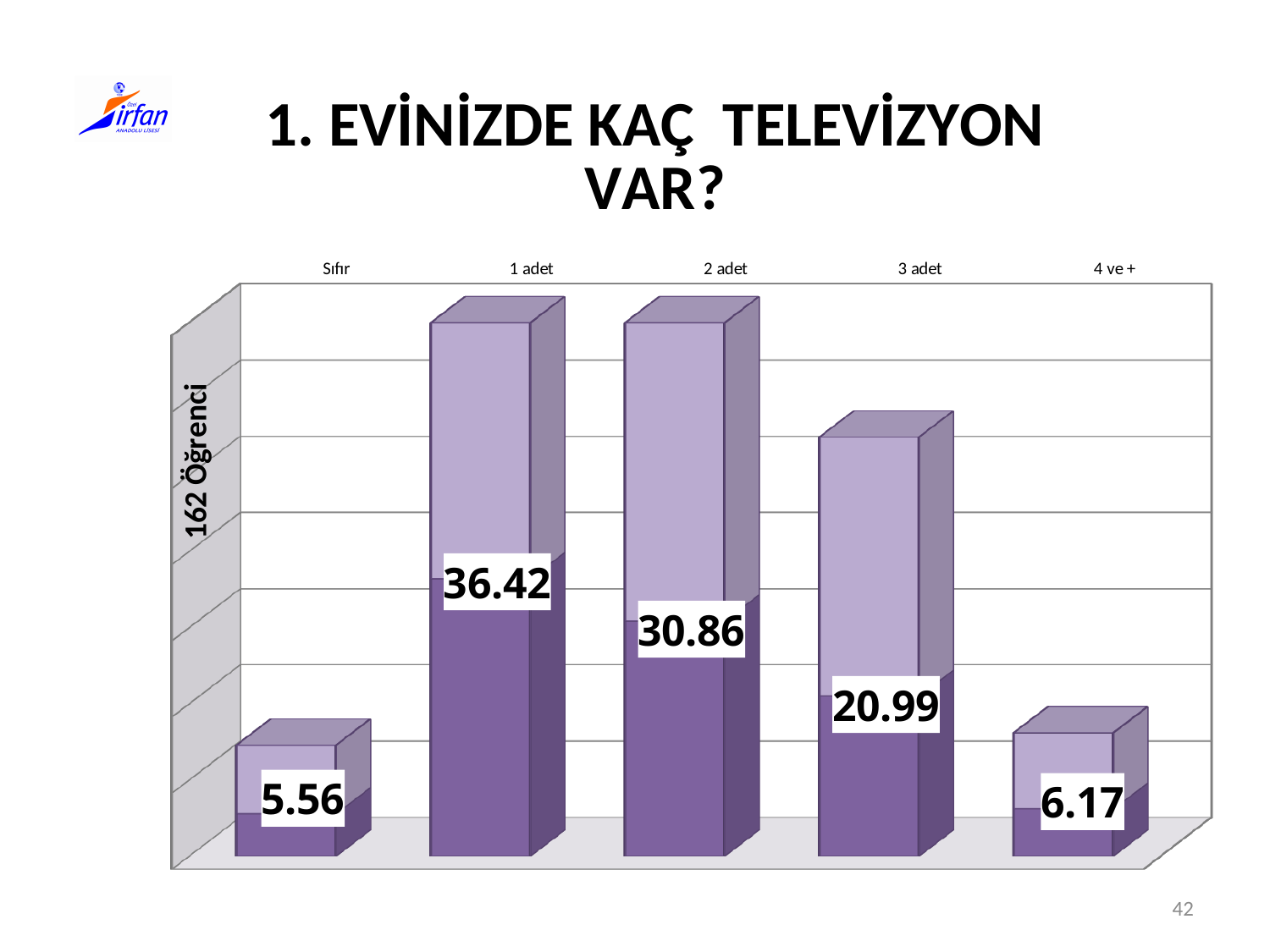
Which category has the highest value? 1 adet Which is larger, the value for "2 adet" or the value for "3 adet"? 2 adet What is the title of the slide? 1. EVİNİZDE KAÇ TELEVİZYON VAR? What is the difference between the values for "1 adet" and "2 adet"? 5.56 Which category has the lowest value? Sıfır What is the value for the "Sıfır" category? 5.56 What is the value for the "3 adet" category? 20.99 How many categories are shown on the chart? 5 What kind of chart is shown on the slide? Bar chart What is the value for the "1 adet" category? 36.42 What is the value for the "4 ve +" category? 6.17 What is the label on the vertical axis of the chart? 162 Öğrenci